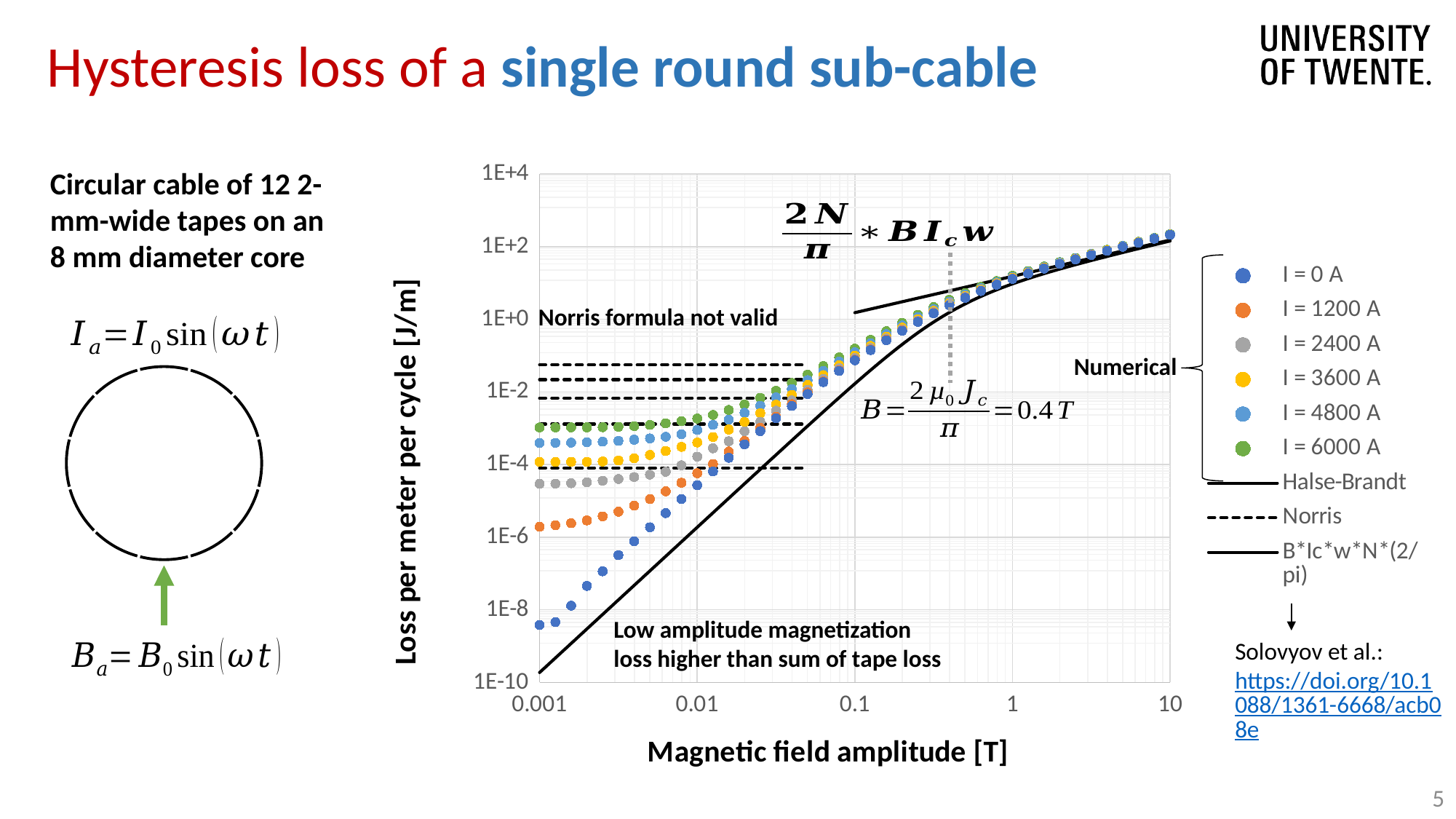
What is the title of the y axis of the chart? Loss per meter per cycle [J/m] At 0.001 T, is the loss for I = 0 A greater or less than 1E-8 J/m? less How many entries does the chart legend list? 9 At a magnetic field amplitude of 0.001 T, which current series has the highest loss? I = 6000 A At 0.001 T, which series has the larger loss, I = 1200 A or I = 4800 A? I = 4800 A Do the plotted loss values rise or fall as the magnetic field amplitude increases? rise At 0.001 T, is the loss for I = 6000 A greater or less than 1E-4 J/m? greater At 0.001 T, is the loss for I = 2400 A greater or less than 1E-4 J/m? less How many numerical current series (I = ... A) are plotted in the chart? 6 At a magnetic field amplitude of 0.001 T, which current series has the lowest loss? I = 0 A What is the title of the x axis of the chart? Magnetic field amplitude [T] What kind of chart is shown on the slide? scatter chart